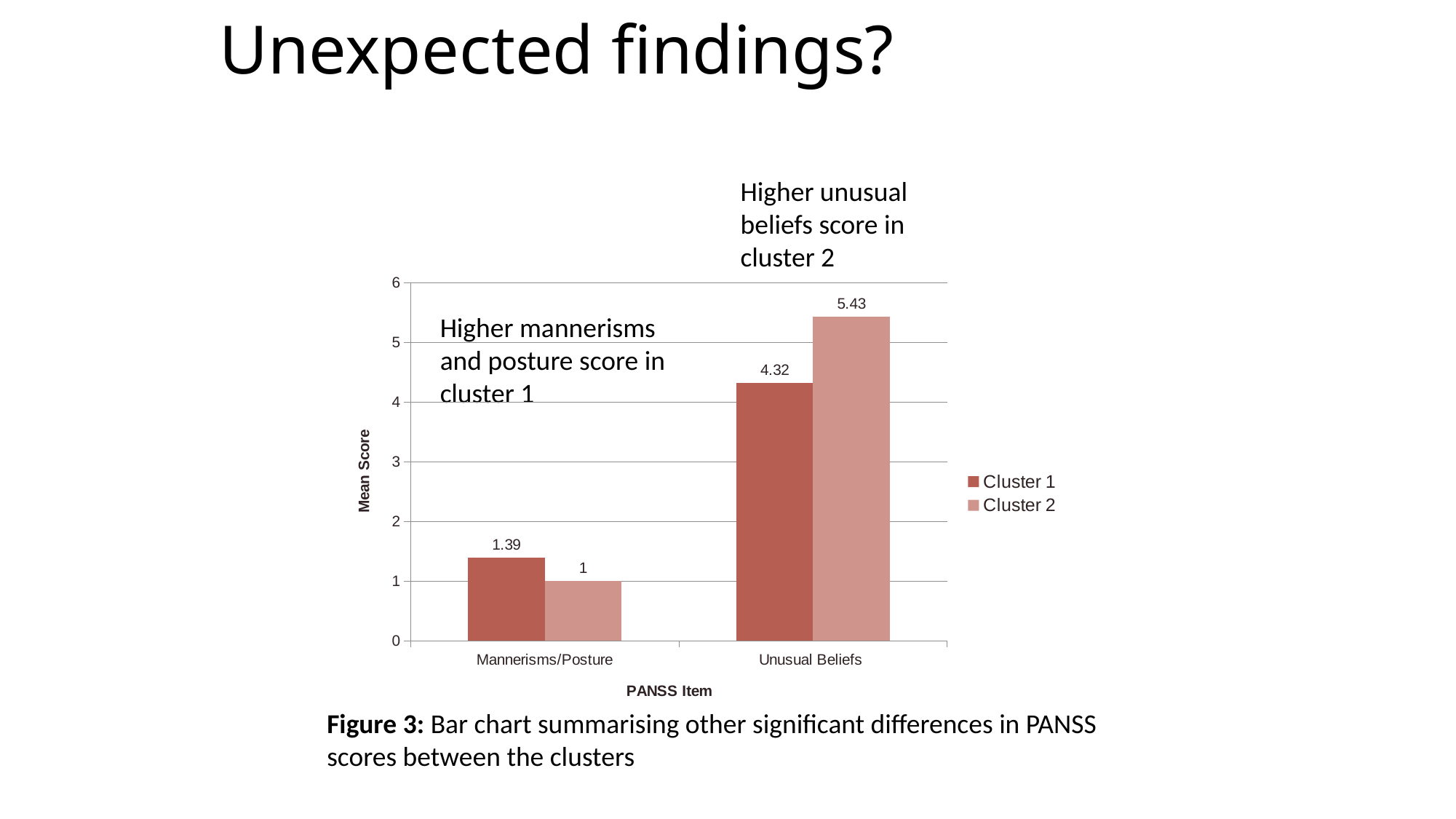
What is the mean score for Cluster 2 on Unusual Beliefs? 5.43 How many series does the legend list? 2 Which PANSS item has the lowest mean score for Cluster 1? Mannerisms/Posture What is the mean score for Cluster 2 on Mannerisms/Posture? 1 How many PANSS items are shown on the x axis? 2 Which PANSS item has the highest mean score for Cluster 2? Unusual Beliefs Which cluster has the higher mean score on Mannerisms/Posture? Cluster 1 What is the difference between the Cluster 2 and Cluster 1 mean scores on Unusual Beliefs? 1.11 What is the mean score for Cluster 1 on Unusual Beliefs? 4.32 Is the Cluster 1 mean score for Unusual Beliefs greater or less than 4? greater What kind of chart is shown on the slide? Bar chart What is the mean score for Cluster 1 on Mannerisms/Posture? 1.39